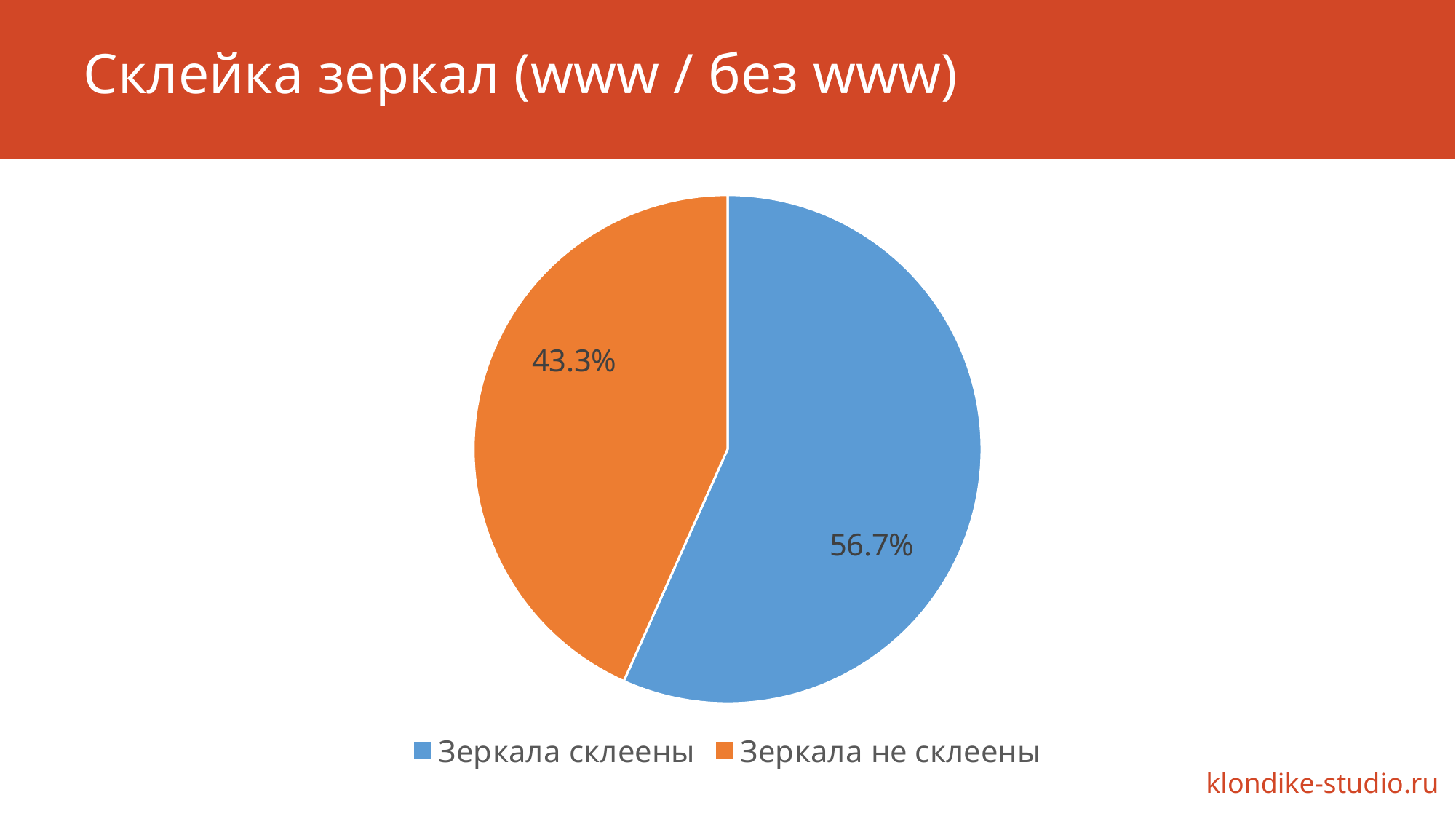
How many entries does the legend list? 2 What is the value for "Зеркала не склеены"? 43.3% What is the difference between the "Зеркала склеены" and "Зеркала не склеены" slices? 13.4% How many slices does the pie chart have? 2 Which slice is the smallest? Зеркала не склеены What is the title of the slide containing the chart? Склейка зеркал (www / без www) Which is larger: "Зеркала склеены" or "Зеркала не склеены"? Зеркала склеены What is the value for "Зеркала склеены"? 56.7% What colour is the "Зеркала не склеены" slice? orange Which slice is the largest? Зеркала склеены What share of the pie does "Зеркала не склеены" take? 43.3% What kind of chart is shown on the slide? pie chart